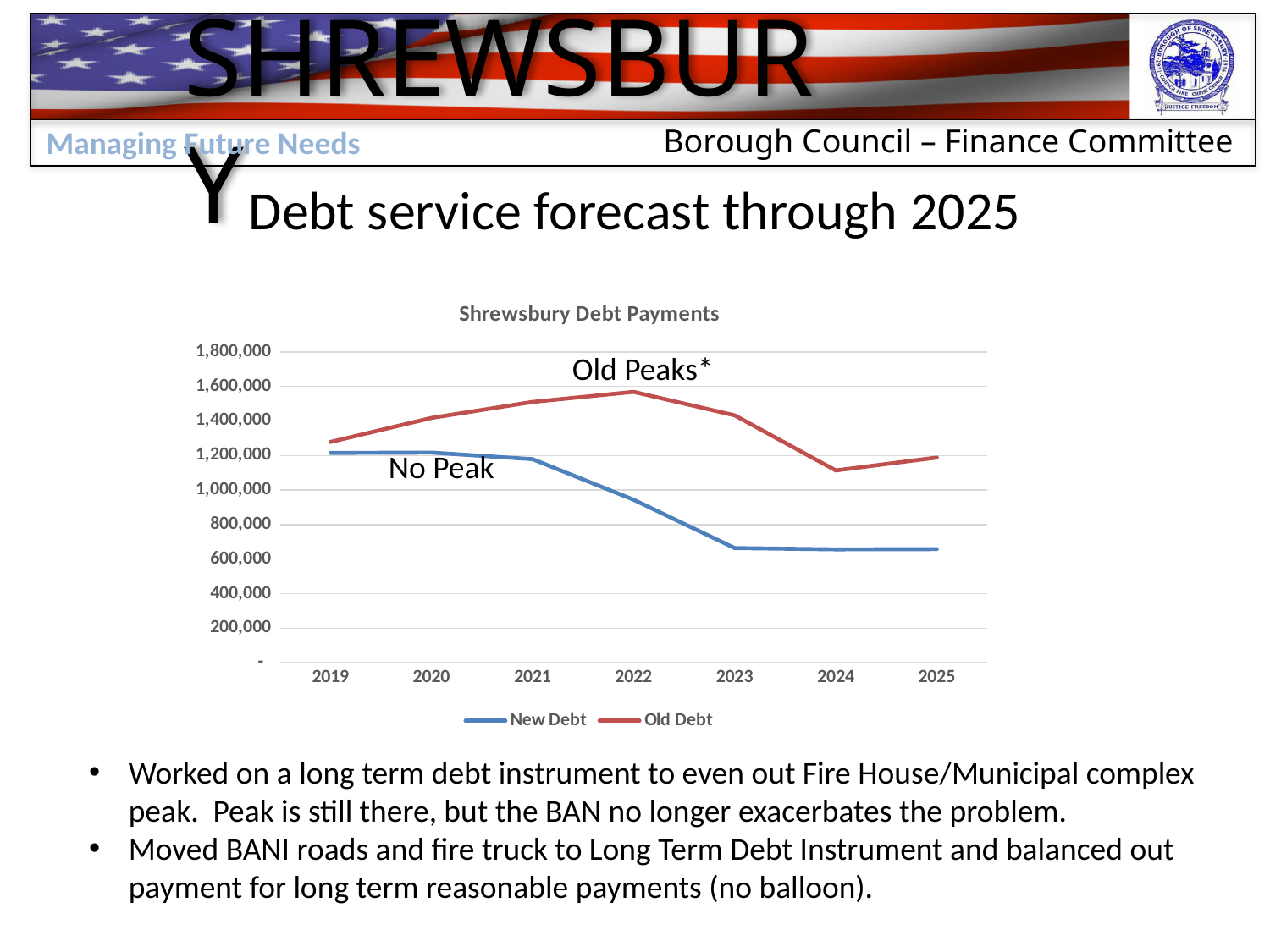
Is the Old Debt value for 2022 greater or less than 1,400,000? greater Is the New Debt value for 2019 greater or less than 1,000,000? greater In which year does the Old Debt series reach its lowest value? 2024 Which colour is used for the Old Debt line? red Is the New Debt value for 2023 greater or less than 800,000? less How many series does the legend of the chart list? 2 How many years are plotted along the x axis of the chart? 7 In 2022, which series has the larger value, New Debt or Old Debt? Old Debt What is the title of the chart? Shrewsbury Debt Payments Does the New Debt series generally rise or fall from 2019 to 2025? fall What kind of chart is shown on the slide? line chart In which year does the Old Debt series reach its highest value? 2022